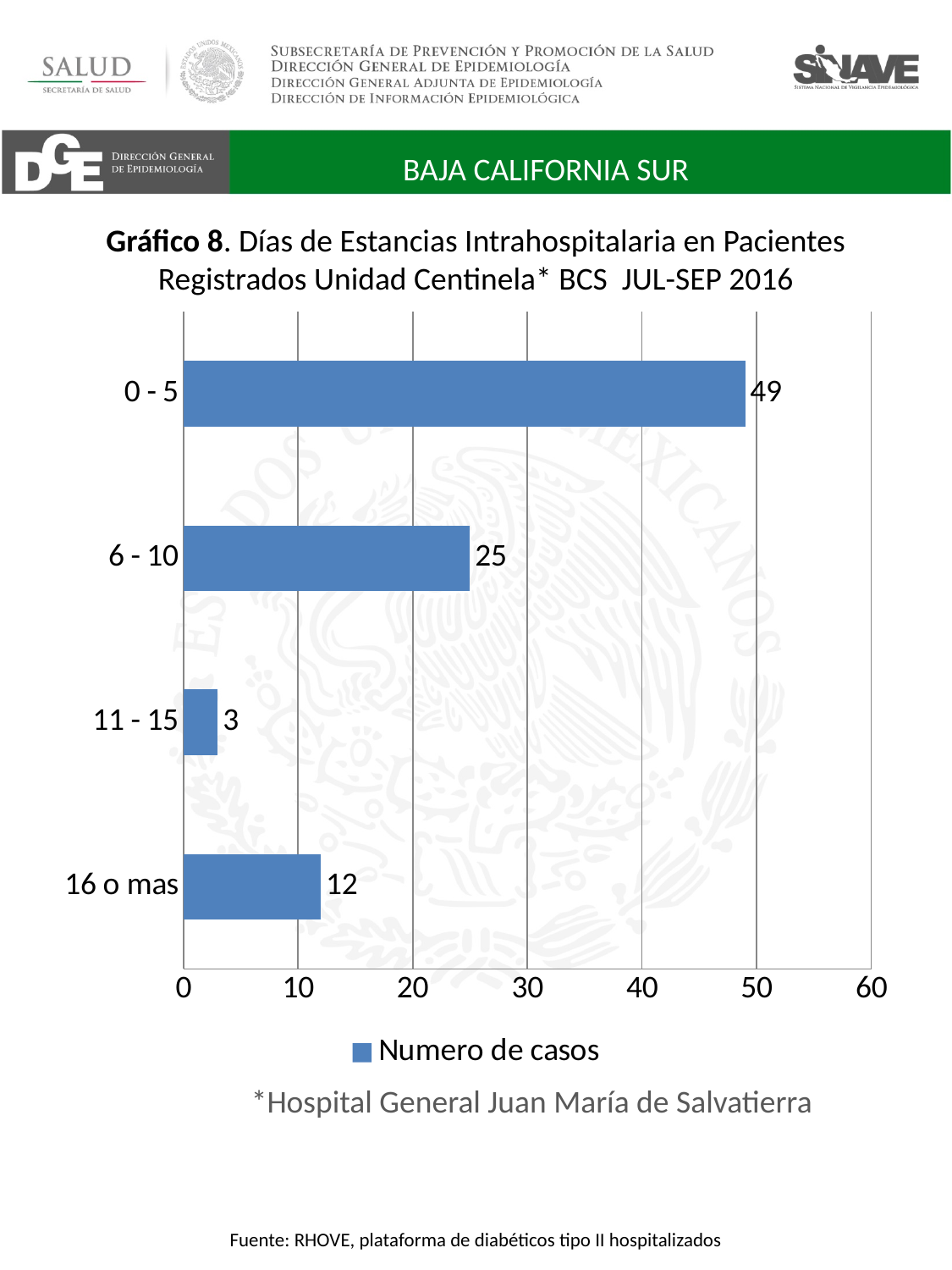
Which category has the lowest number of cases? 11 - 15 What is the number of cases for the 11 - 15 days category? 3 What kind of chart is shown on the slide? Bar chart What is the number of cases for the 6 - 10 days category? 25 What is the difference in number of cases between the 0 - 5 and 6 - 10 categories? 24 What series name does the legend show? Numero de casos How many categories are shown on the chart? 4 Is the value for 6 - 10 greater or less than 20? greater Which category has the highest number of cases? 0 - 5 Which has more cases, 16 o mas or 11 - 15? 16 o mas What is the number of cases for the 16 o mas category? 12 What is the number of cases for the 0 - 5 days category? 49